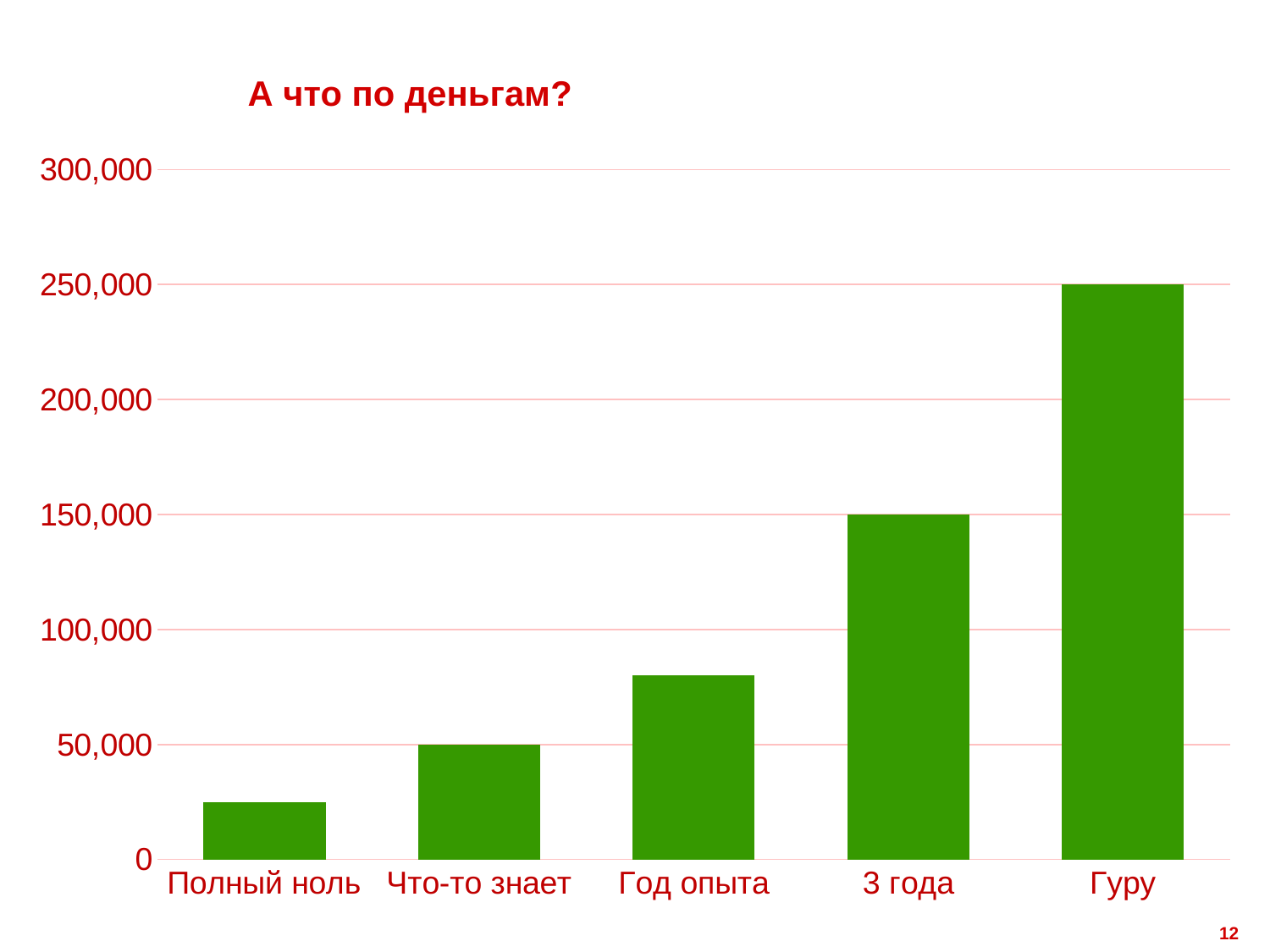
Do the values rise or fall from left to right along the x axis? rise Which category has the highest value? Гуру What is the value for Гуру? 250,000 How many categories are shown on the x axis? 5 What type of chart is shown on the slide? bar chart What is the value for 3 года? 150,000 Which category has the lowest value? Полный ноль What is the title of the chart? А что по деньгам? What is the difference between the values for Гуру and 3 года? 100,000 What is the value for Что-то знает? 50,000 Is the value for Год опыта greater or less than 100,000? less Is the value for Полный ноль greater or less than 50,000? less